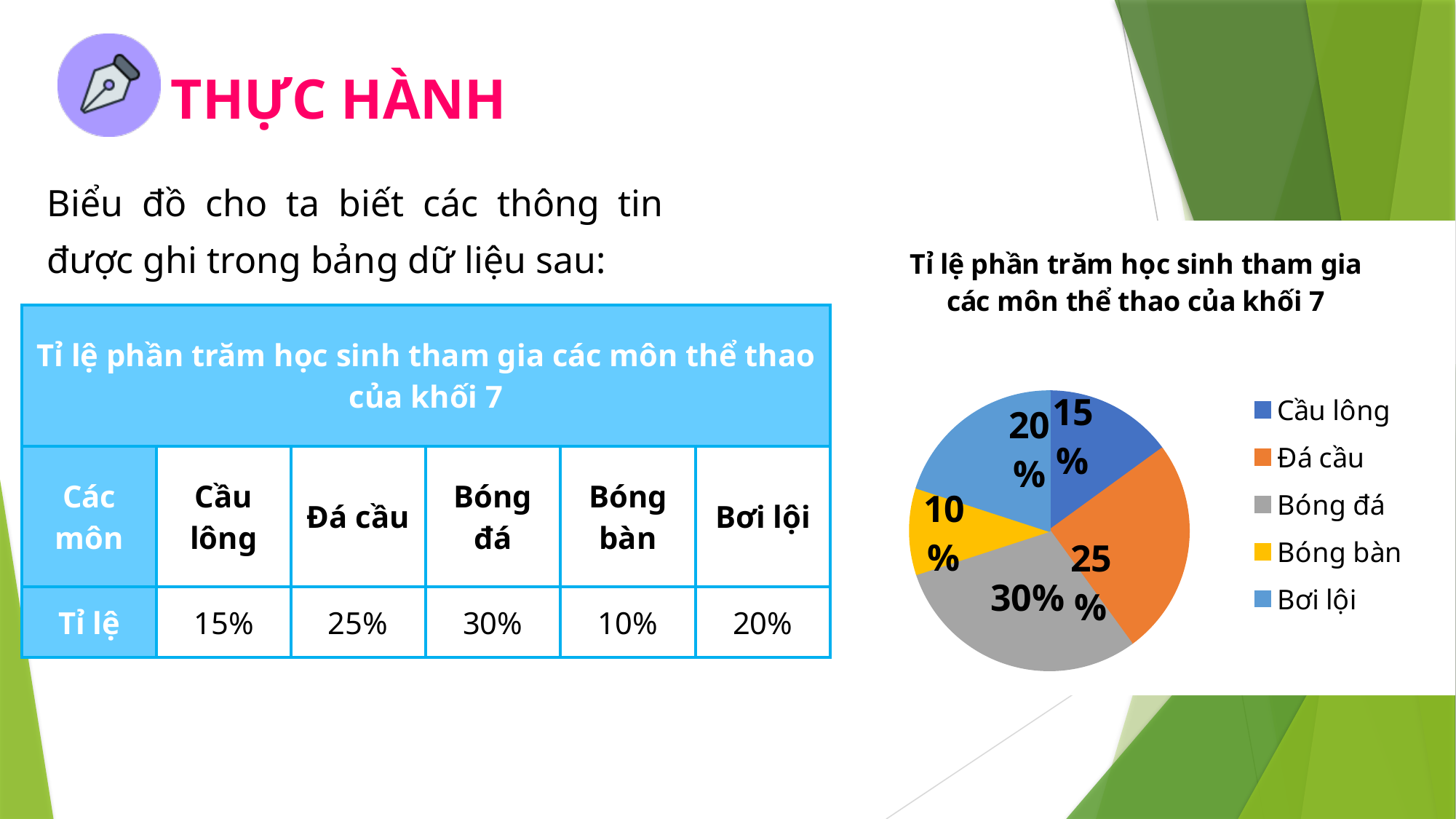
What is the title of the pie chart? Tỉ lệ phần trăm học sinh tham gia các môn thể thao của khối 7 What percentage of the pie chart is Đá cầu? 25% What percentage of the pie chart is Bóng đá? 30% Which has a larger share, Đá cầu or Bơi lội? Đá cầu What percentage of the pie chart is Bơi lội? 20% Which sport has the smallest share of the pie chart? Bóng bàn What is the difference in percentage points between Bóng đá and Cầu lông? 15% What type of chart is shown on the slide? pie chart What percentage of the pie chart is Bóng bàn? 10% How many categories does the pie chart legend list? 5 Which sport has the largest share of the pie chart? Bóng đá What percentage of the pie chart is Cầu lông? 15%